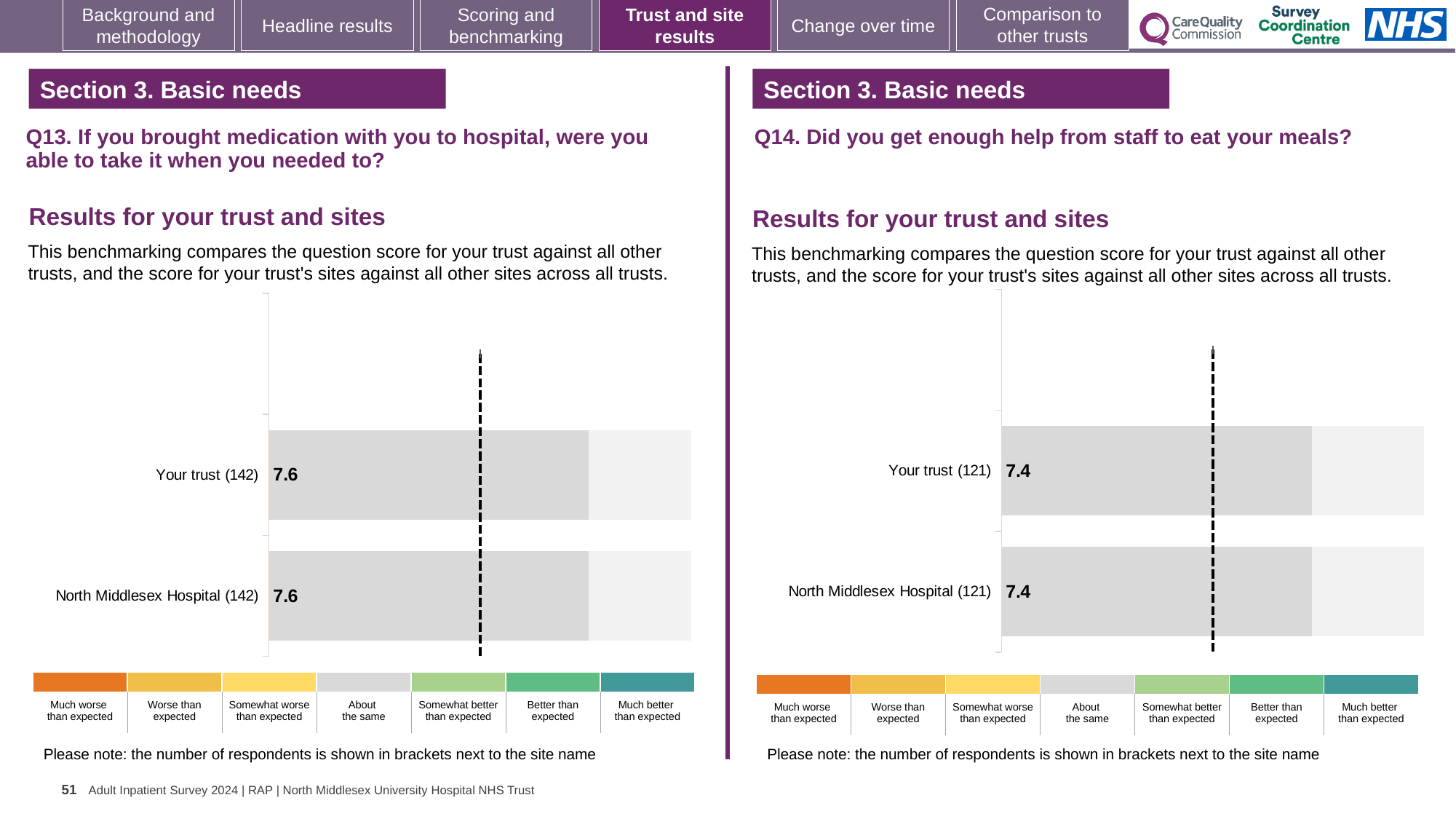
In the Q13 chart on the left, what is the difference between the score for Your trust and the score for North Middlesex Hospital? 0 In the Q13 chart on the left, what is the score for Your trust? 7.6 How many bars are plotted in the Q13 chart on the left? 2 What kind of chart is used for the Q13 results on the left? Bar chart In the Q14 chart on the right, how many respondents are shown in brackets next to North Middlesex Hospital? 121 Is the score for Your trust in the Q14 chart on the right greater or less than the score for Your trust in the Q13 chart on the left? less How many bars are plotted in the Q14 chart on the right? 2 In the Q13 chart on the left, what is the score for North Middlesex Hospital? 7.6 In the Q14 chart on the right, what is the difference between the score for Your trust and the score for North Middlesex Hospital? 0 In the Q14 chart on the right, what is the score for North Middlesex Hospital? 7.4 In the Q14 chart on the right, what is the score for Your trust? 7.4 In the Q13 chart on the left, how many respondents are shown in brackets next to Your trust? 142